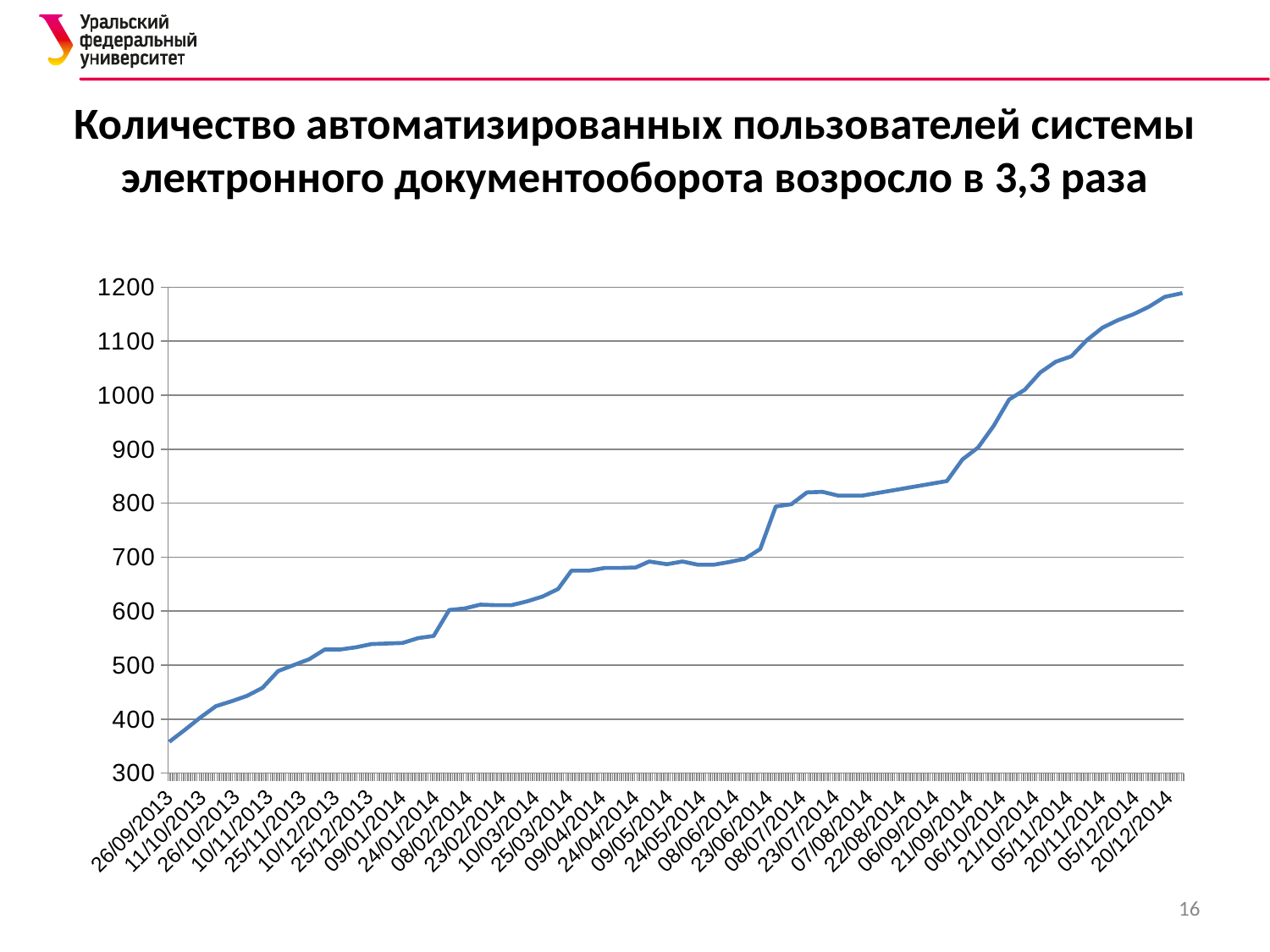
At which date on the x axis is the plotted value highest? 20/12/2014 At which date on the x axis is the plotted value lowest? 26/09/2013 What kind of chart is shown on the slide? line chart What are the lowest and highest values shown on the vertical axis? 300 and 1200 Do the values rise or fall along the x axis from 26/09/2013 to 20/12/2014? rise Is the value at 26/09/2013 greater or less than 400? less Is the value at 20/12/2014 greater or less than 1100? greater Which has the larger value, 23/06/2014 or 08/07/2014? 08/07/2014 What is the title of the slide above the chart? Количество автоматизированных пользователей системы электронного документооборота возросло в 3,3 раза Is the value at 25/03/2014 greater or less than 700? less